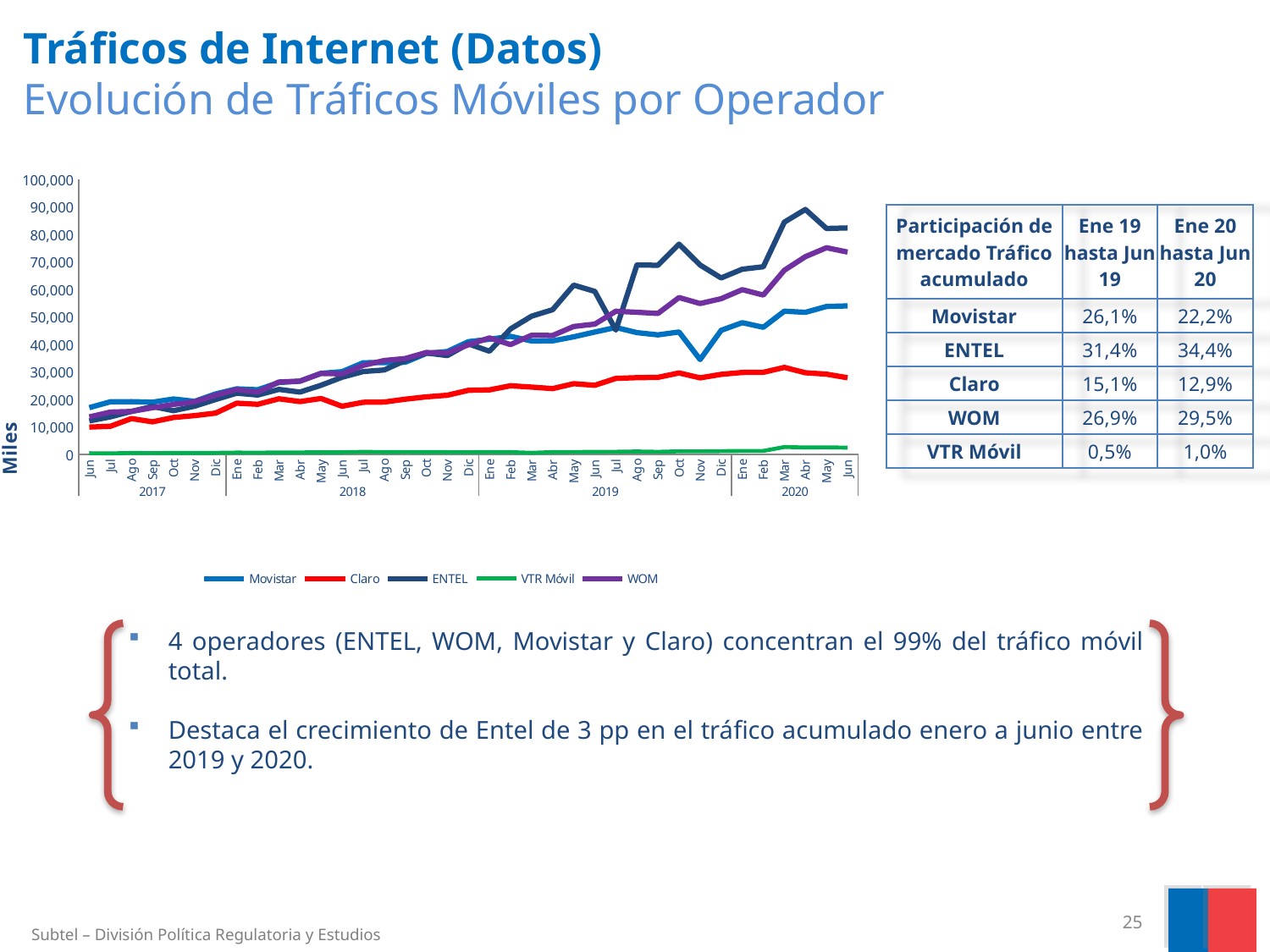
Is the value for VTR Móvil at Jun 2020 greater or less than 10,000? less Is the value for Movistar at Jun 2020 greater or less than 40,000? greater At Jun 2020, which is larger in the chart: WOM or Movistar? WOM Is the value for Claro at Jun 2020 greater or less than 40,000? less Which operators are listed in the chart's legend? Movistar, Claro, ENTEL, VTR Móvil, WOM Which operator has the lowest traffic across the whole chart? VTR Móvil Does the ENTEL line rise or fall overall from Jun 2017 to Jun 2020? rise Which operator has the highest traffic at Jun 2020 in the chart? ENTEL How many series does the chart's legend list? 5 What kind of chart is shown on the slide? line chart What is the label on the chart's vertical axis? Miles